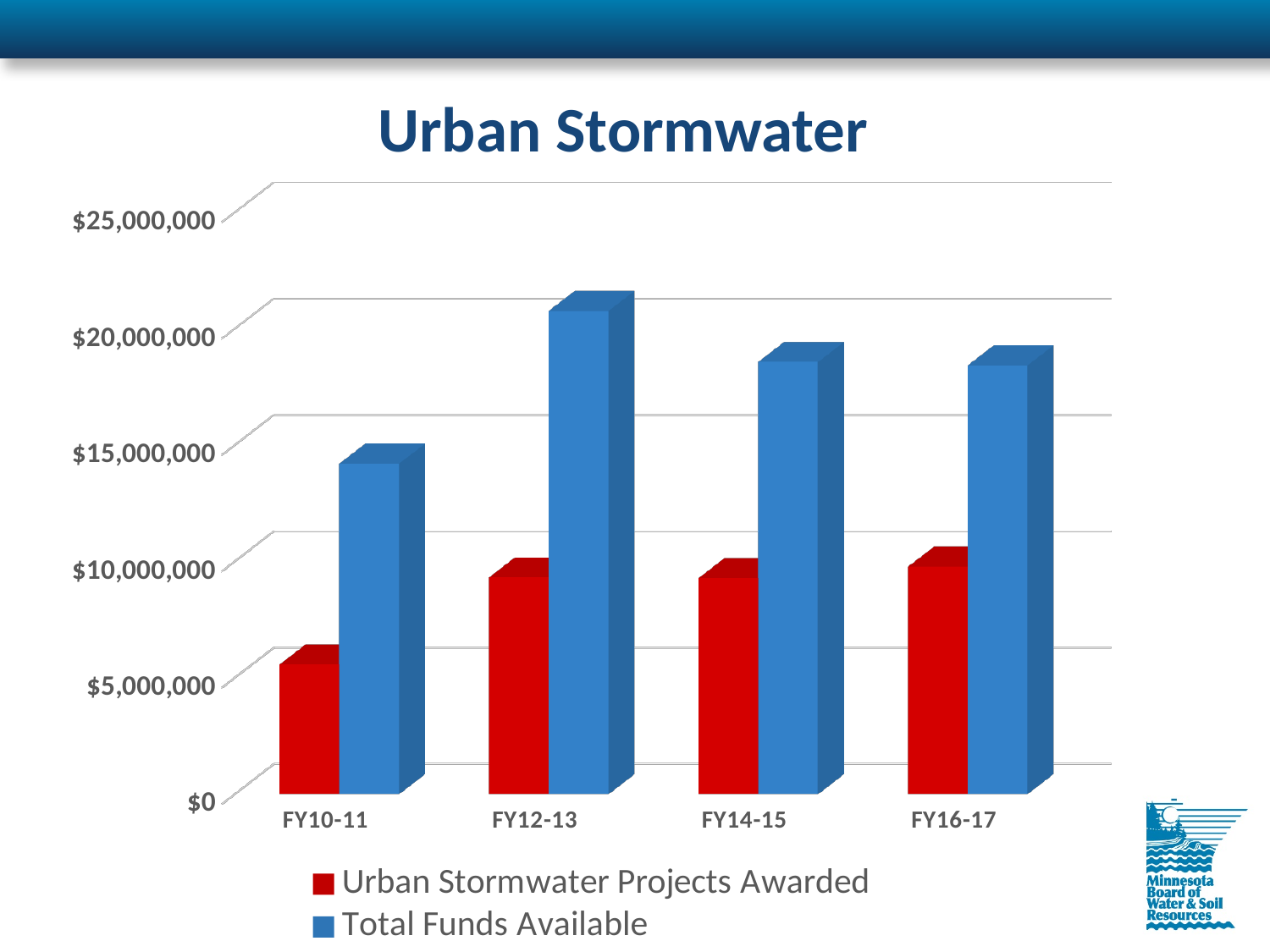
What kind of chart is shown on the slide? Bar chart What is the title of the chart? Urban Stormwater Is the value for Total Funds Available in FY14-15 greater or less than $15,000,000? greater Which colour represents Total Funds Available in the legend? Blue Which is larger: Total Funds Available in FY12-13 or Total Funds Available in FY14-15? FY12-13 In which fiscal year is Total Funds Available highest? FY12-13 How many series does the legend list? 2 Is the value for Total Funds Available in FY12-13 greater or less than $20,000,000? greater Is the value for Urban Stormwater Projects Awarded in FY10-11 greater or less than $10,000,000? less How many fiscal year categories are shown on the x axis? 4 In which fiscal year is Urban Stormwater Projects Awarded lowest? FY10-11 Does Urban Stormwater Projects Awarded rise or fall from FY10-11 to FY12-13? Rise